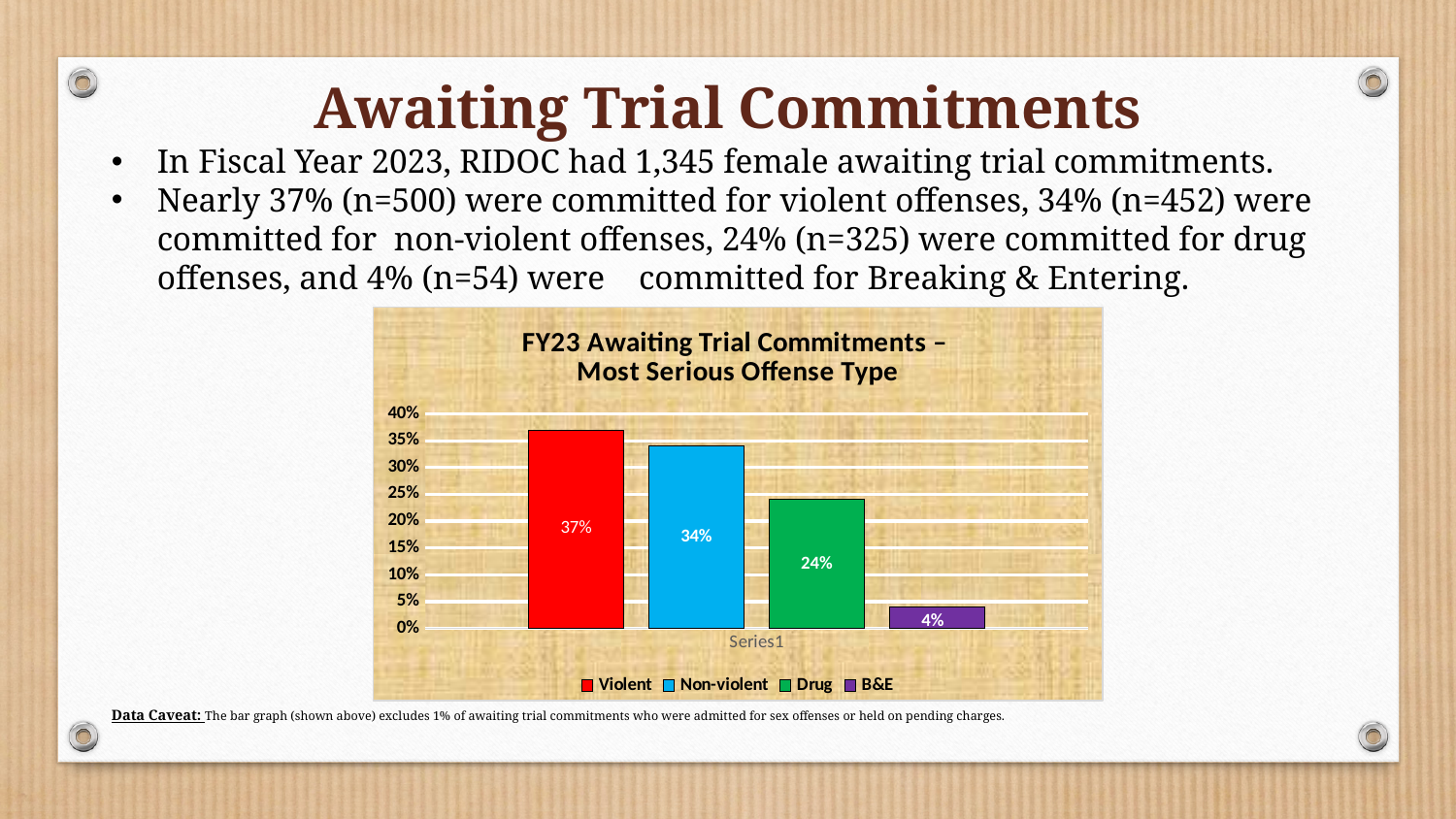
What is the value for B&E in the chart? 4% What is the difference between the Violent and Drug values? 13% What is the value for Drug in the chart? 24% Which offense type has the lowest value in the chart? B&E What is the value for Violent in the chart? 37% What is the title of the chart? FY23 Awaiting Trial Commitments – Most Serious Offense Type What is the difference between the Non-violent and B&E values? 30% Which is larger, the value for Drug or the value for B&E? Drug How many offense types are plotted in the chart? 4 What is the value for Non-violent in the chart? 34% What kind of chart is shown on the slide? Bar chart Which offense type has the highest value in the chart? Violent